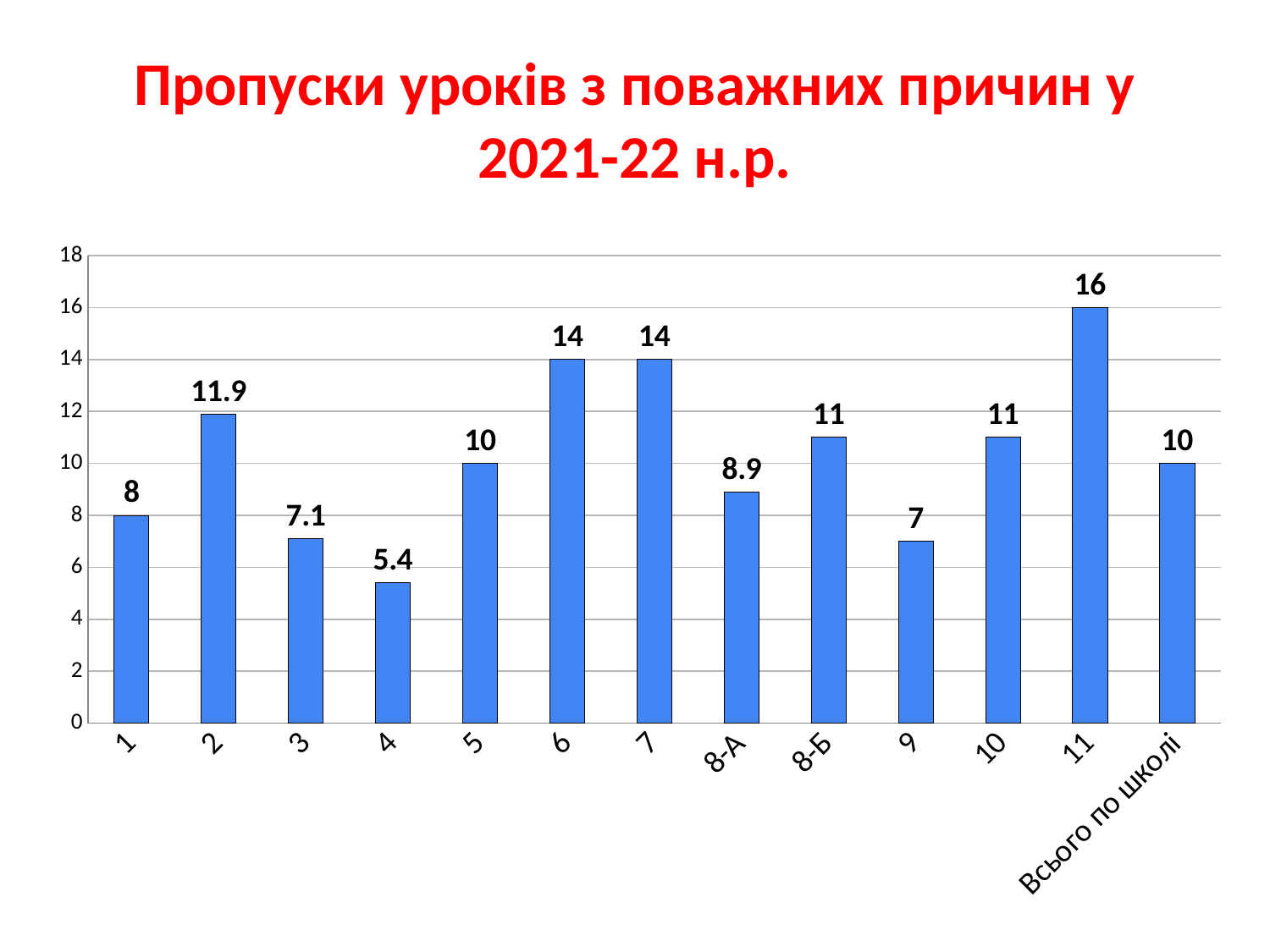
Which is larger, the value for category 5 or the value for category 9? 5 What kind of chart is shown on the slide? bar chart What is the difference between the values for category 11 and category 4? 10.6 How many categories are shown on the x axis? 13 What is the value for category 8-А? 8.9 What is the title of the slide? Пропуски уроків з поважних причин у 2021-22 н.р. What is the value for 'Всього по школі'? 10 Which category has the lowest value? 4 Which category has the highest value? 11 What is the value for category 2? 11.9 Is the value for category 6 greater or less than 12? greater What is the difference between the values for category 2 and category 3? 4.8